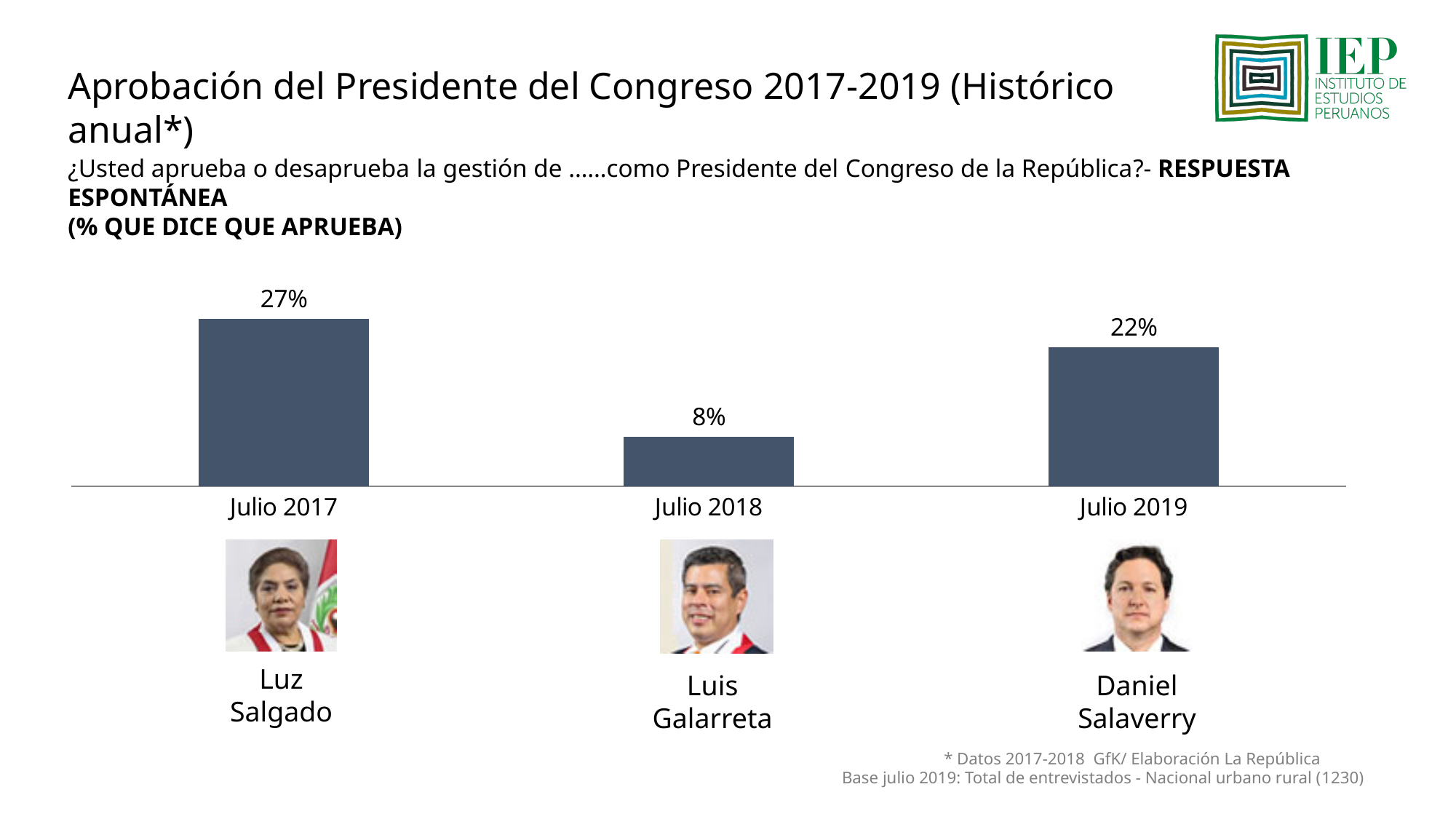
Which Congress president is associated with the Julio 2019 bar? Daniel Salaverry What is the difference between the approval values for Julio 2019 and Julio 2018? 14% What is the approval value for Julio 2017? 27% Which period has the highest approval value? Julio 2017 Which period has the lowest approval value? Julio 2018 What is the approval value for Julio 2019? 22% What is the approval value for Julio 2018? 8% What kind of chart is shown on the slide? Bar chart Does the approval value rise or fall from Julio 2017 to Julio 2018? Fall How many periods are shown on the chart? 3 What is the difference between the approval values for Julio 2017 and Julio 2018? 19% Which is larger, the value for Julio 2017 or the value for Julio 2019? Julio 2017